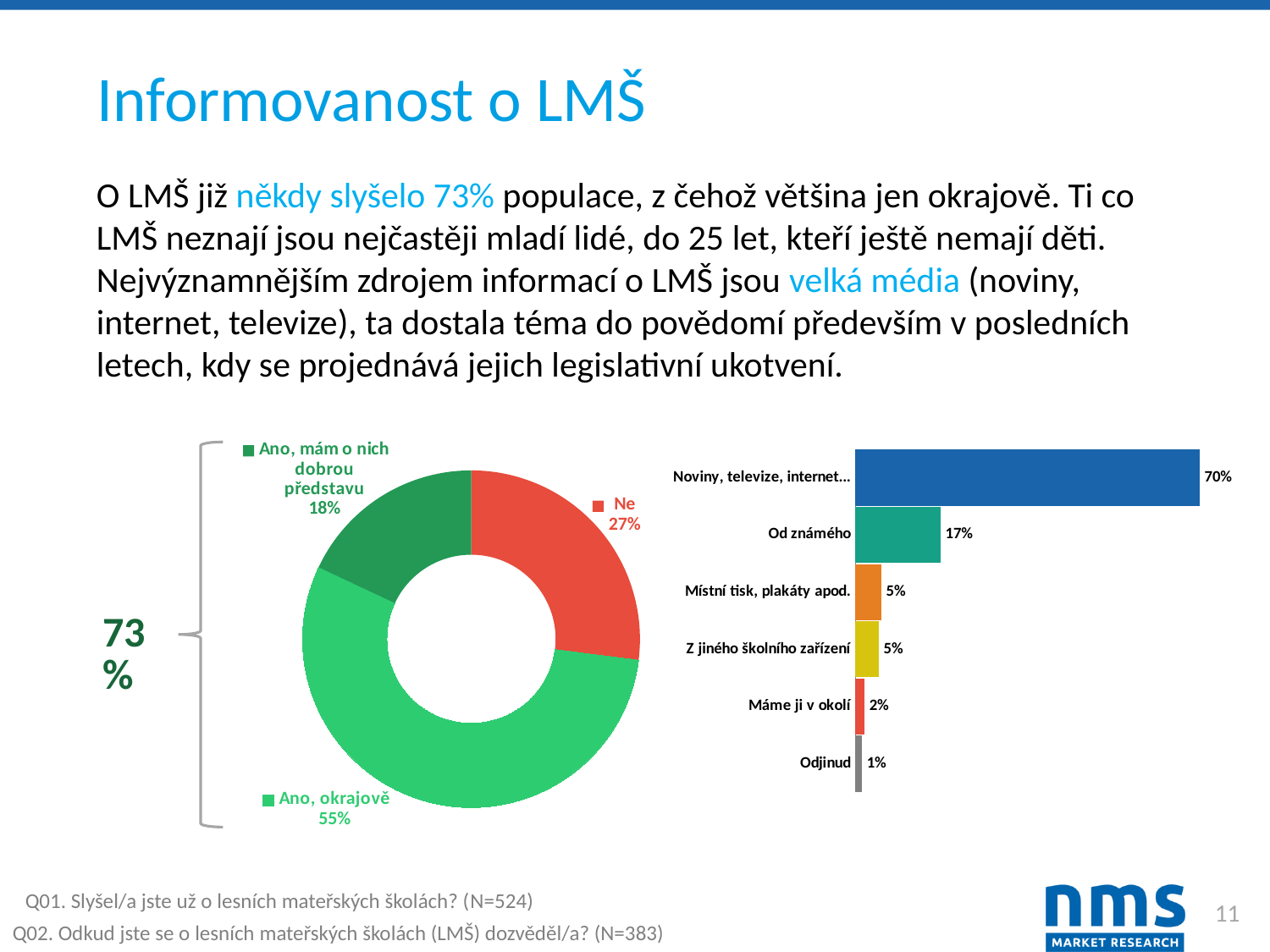
In the bar chart on the right, what is the difference between "Noviny, televize, internet..." and "Od známého"? 53% In the bar chart on the right, what is the value for "Noviny, televize, internet..."? 70% In the donut chart on the left, what is the combined share of the two "Ano" answers? 73% What type of chart is shown on the right side of the slide? Bar chart In the donut chart on the left, what share of respondents answered "Ano, mám o nich dobrou představu"? 18% In the donut chart on the left, how many slices are there? 3 In the bar chart on the right, which category has the lowest value? Odjinud In the donut chart on the left, which answer has the largest share? Ano, okrajově In the donut chart on the left, what share of respondents answered "Ano, okrajově"? 55% In the bar chart on the right, how many categories are shown? 6 In the donut chart on the left, what share of respondents answered "Ne"? 27% In the bar chart on the right, what is the value for "Od známého"? 17%